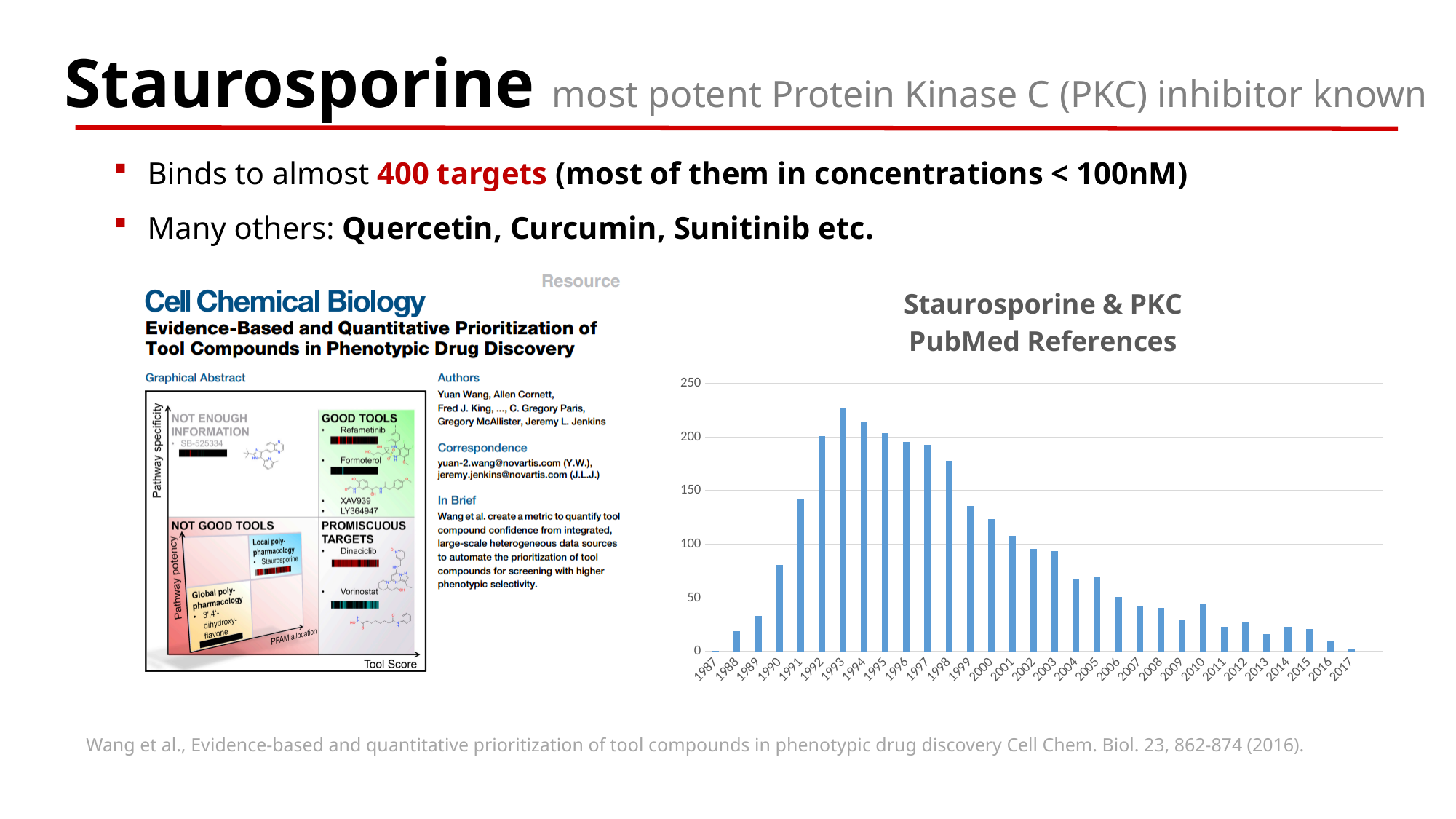
Which year has the larger value, 1991 or 2001? 1991 Is the value for 1992 greater or less than 150? greater How many years are plotted on the x axis of the chart? 31 What is the title of the chart on the slide? Staurosporine & PKC PubMed References What kind of chart is shown on the slide? bar chart Is the value for 2016 greater or less than 50? less Which year has the highest number of PubMed references in the chart? 1993 Do the values generally rise or fall from 1993 to 2017? fall Is the value for 1990 greater or less than 50? greater Which year has the larger value, 2005 or 2015? 2005